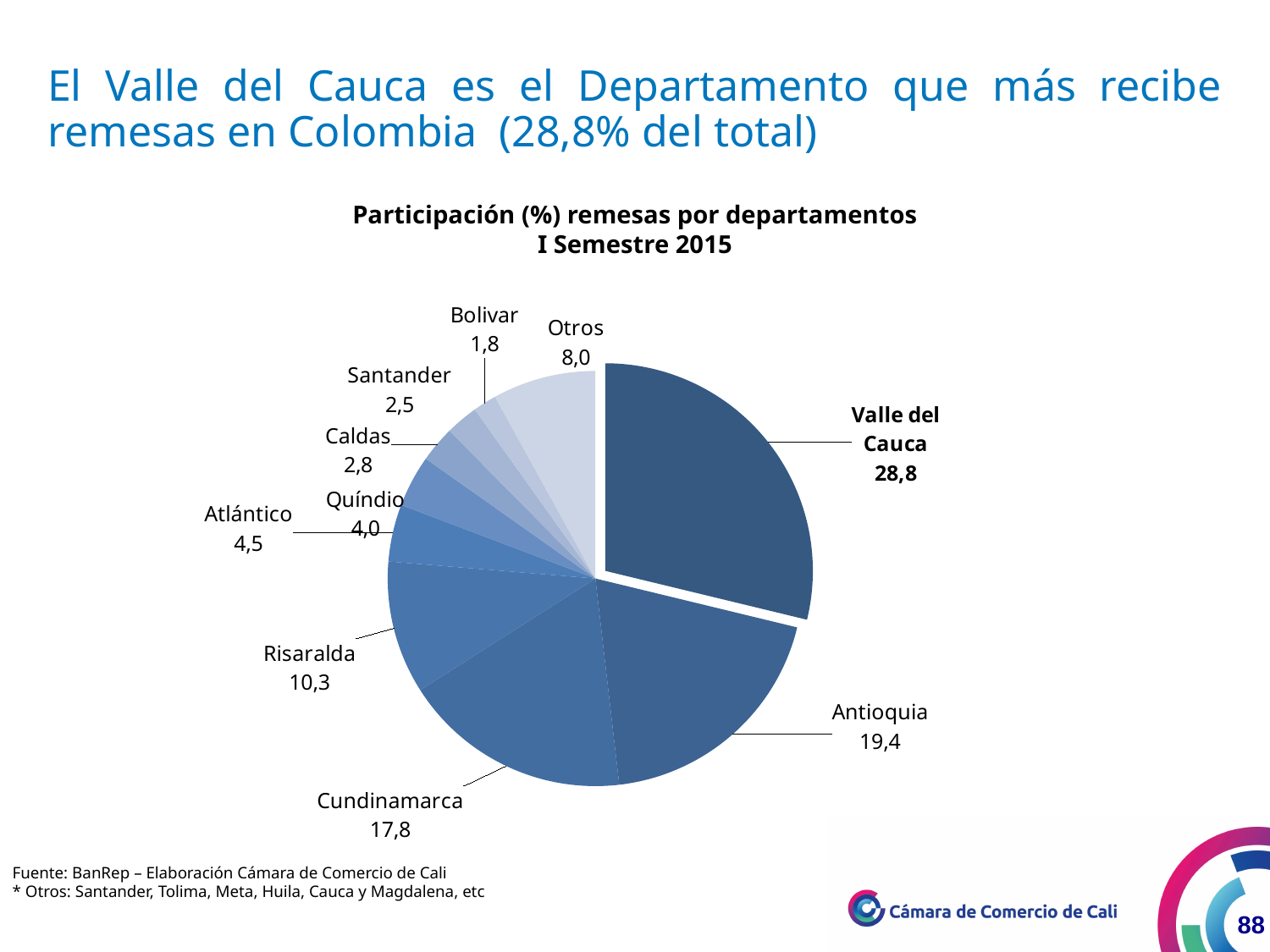
What is the value shown for Risaralda? 10,3 What is the value shown for Otros? 8,0 What type of chart is shown on the slide? pie chart How many slices does the pie chart have? 10 Which labelled slice has the smallest value? Bolivar Which department has the largest slice of the pie? Valle del Cauca What is the value shown for Valle del Cauca? 28,8 Which is larger, the value for Cundinamarca or the value for Risaralda? Cundinamarca What is the difference between the values for Valle del Cauca and Antioquia? 9,4 What is the difference between the values for Atlántico and Quíndio? 0,5 What is the value shown for Antioquia? 19,4 What is the title of the chart? Participación (%) remesas por departamentos I Semestre 2015